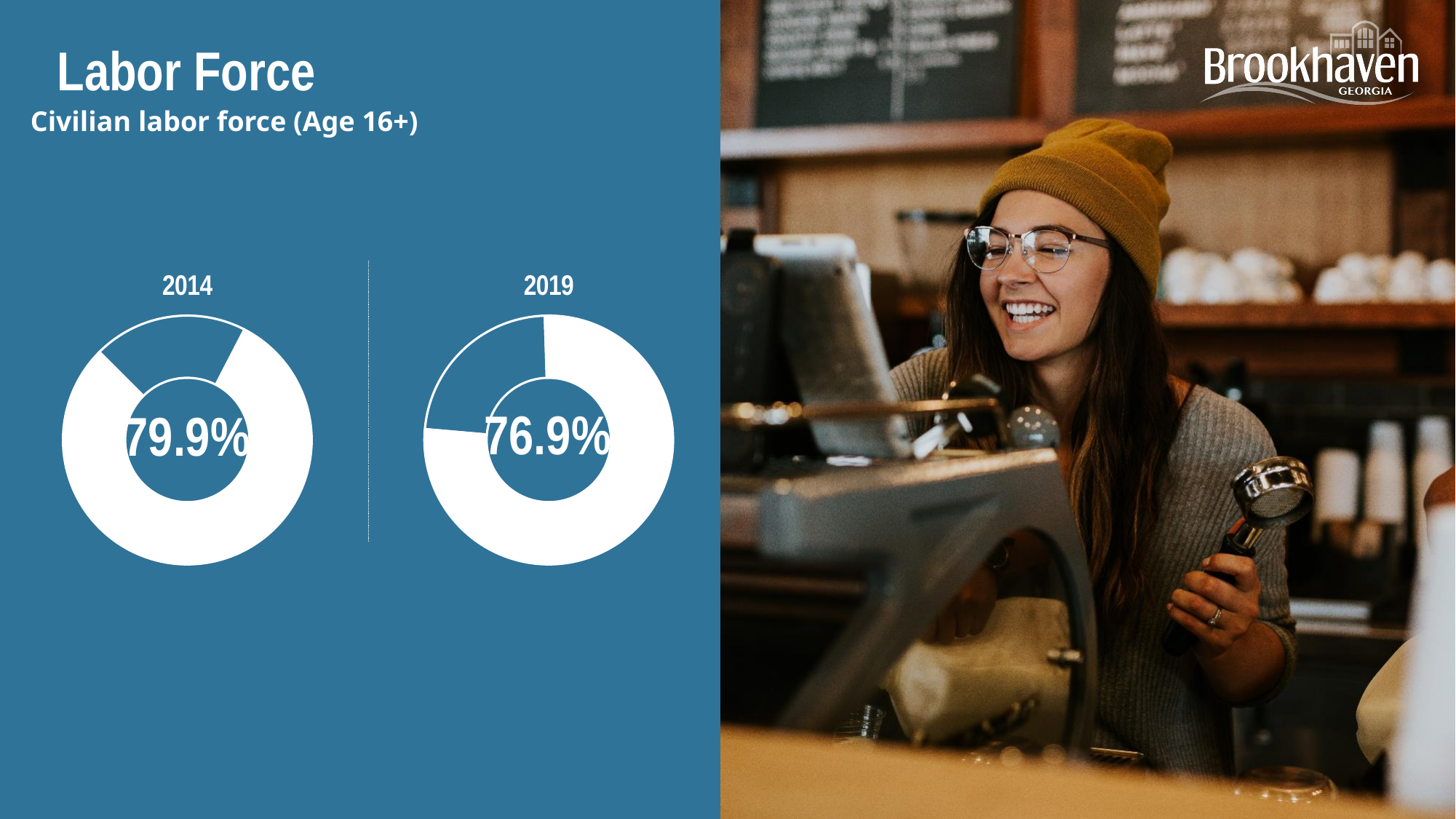
On the 2014 chart, what percentage is shown in the centre of the donut? 79.9% What is the difference in percentage points between the 2014 value and the 2019 value? 3 percentage points What is the title of the slide? Labor Force Is the 2019 value greater or less than 80%? less How many donut charts are shown on the slide? 2 Which year shows the higher civilian labor force percentage, 2014 or 2019? 2014 Is the 2014 value greater or less than 75%? greater Which year shows the lower civilian labor force percentage, 2014 or 2019? 2019 What kind of chart is used to show the 2014 and 2019 values? donut (pie) chart Did the civilian labor force percentage rise or fall from 2014 to 2019? fall On the 2019 chart, what percentage is shown in the centre of the donut? 76.9% What is the subtitle describing the data shown in the charts? Civilian labor force (Age 16+)